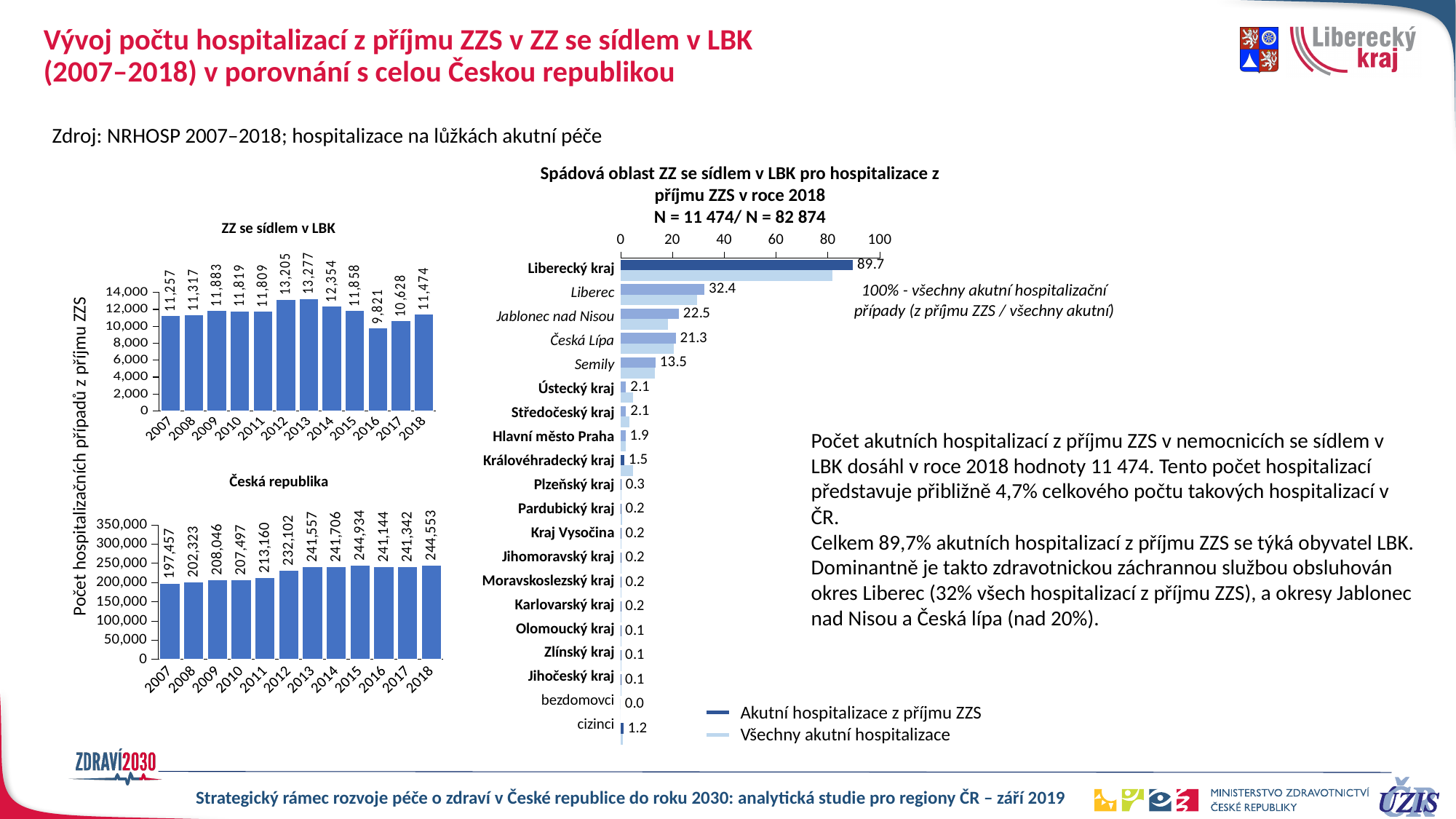
In the 'Spádová oblast ZZ se sídlem v LBK' chart, what is the value for Liberecký kraj for Akutní hospitalizace z příjmu ZZS? 89.7 What kind of chart is the 'Spádová oblast ZZ se sídlem v LBK' chart? bar chart In the 'ZZ se sídlem v LBK' chart, what is the value for 2018? 11,474 In the 'Česká republika' chart, what is the difference between the values for 2018 and 2007? 47,096 In the 'Česká republika' chart, how many years are plotted? 12 In the 'Česká republika' chart, what is the value for 2007? 197,457 In the 'Spádová oblast ZZ se sídlem v LBK' chart, which is larger for Akutní hospitalizace z příjmu ZZS: Liberec or Jablonec nad Nisou? Liberec In the 'ZZ se sídlem v LBK' chart, what is the difference between the values for 2013 and 2016? 3,456 In the 'ZZ se sídlem v LBK' chart, which year has the highest value? 2013 In the 'Česká republika' chart, which year has the highest value? 2015 In the 'ZZ se sídlem v LBK' chart, which year has the lowest value? 2016 In the 'Spádová oblast ZZ se sídlem v LBK' chart, how many series does the legend list? 2